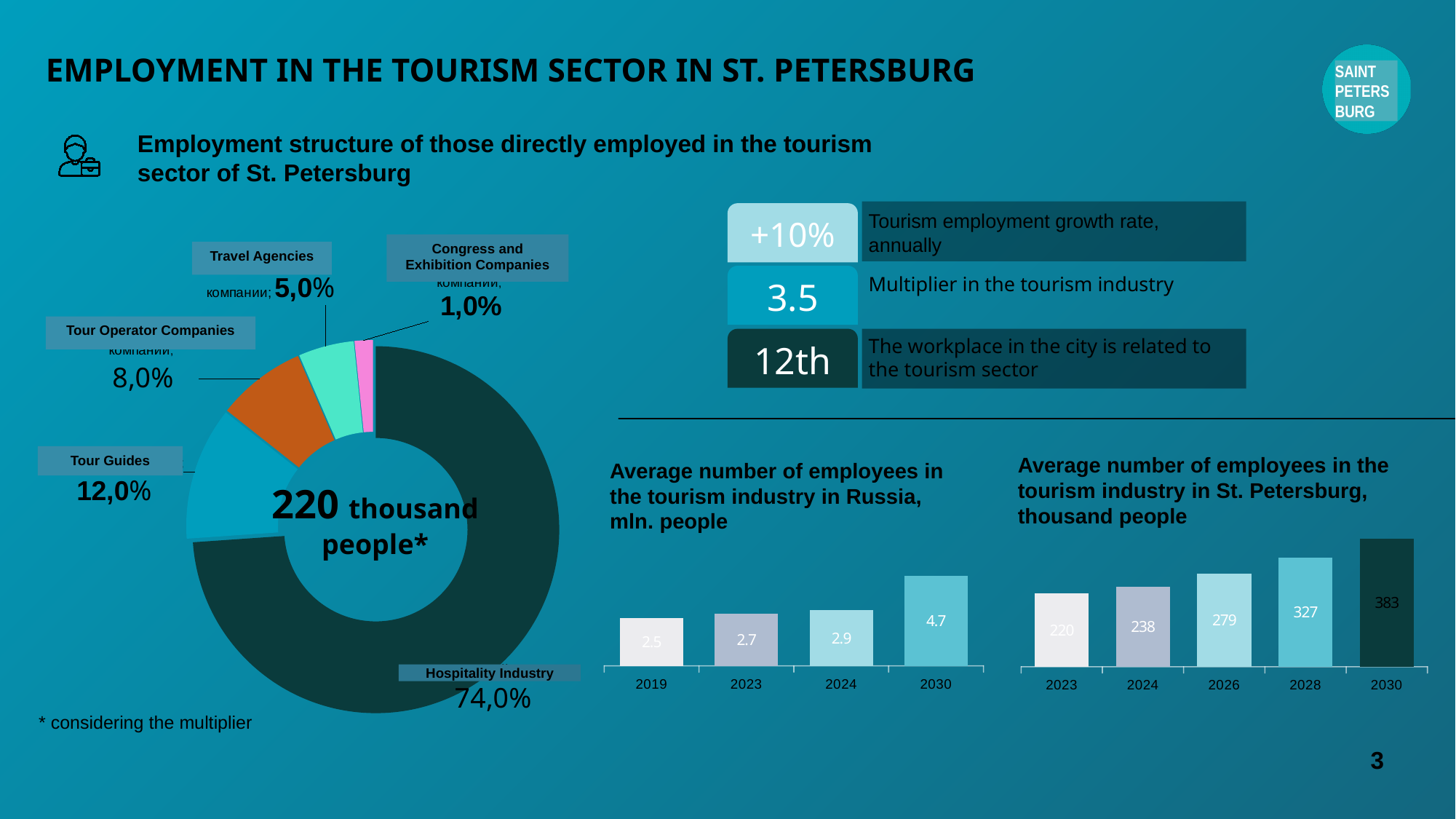
In the donut chart on the employment structure, what share does the Hospitality Industry hold? 74,0% In the chart 'Average number of employees in the tourism industry in St. Petersburg, thousand people', what is the difference between 2030 and 2023? 163 In the chart 'Average number of employees in the tourism industry in St. Petersburg, thousand people', what is the value for 2028? 327 What kind of chart is 'Average number of employees in the tourism industry in St. Petersburg, thousand people'? bar chart In the chart 'Average number of employees in the tourism industry in Russia, mln. people', what is the difference between 2024 and 2019? 0.4 In the donut chart on the employment structure, how many categories are shown? 5 In the chart 'Average number of employees in the tourism industry in Russia, mln. people', do the values rise or fall from 2019 to 2030? rise In the donut chart on the employment structure, which category has the smallest share? Congress and Exhibition Companies In the donut chart on the employment structure, what is the difference between the shares of Tour Operator Companies and Travel Agencies? 3,0% In the donut chart on the employment structure, what is the share for Tour Guides? 12,0% In the chart 'Average number of employees in the tourism industry in Russia, mln. people', what is the value for 2030? 4.7 In the chart 'Average number of employees in the tourism industry in St. Petersburg, thousand people', which year has the highest value? 2030